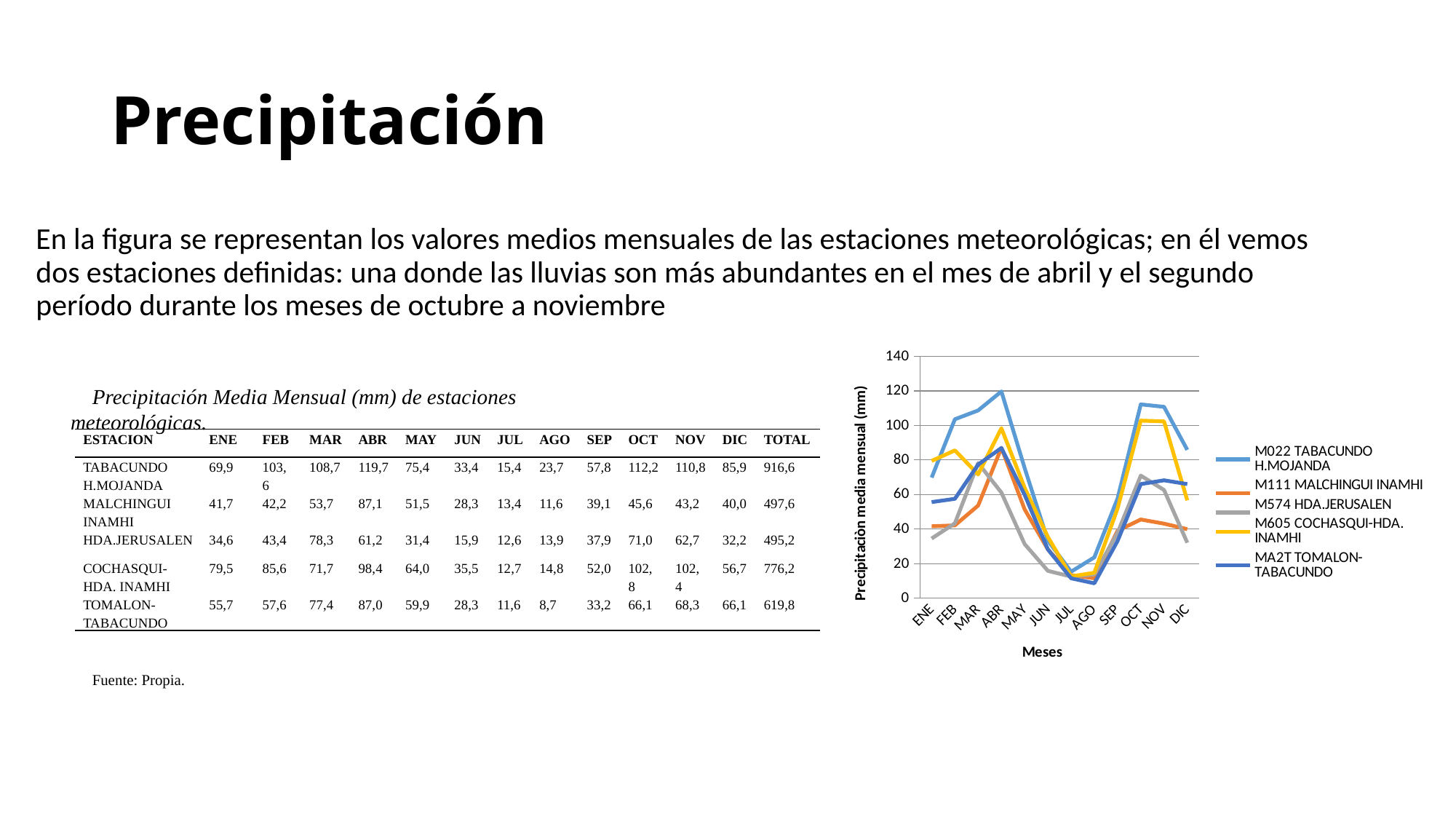
Between ABR and JUL, do the values of the M022 TABACUNDO H.MOJANDA series rise or fall? fall In ABR, which series has the higher value: M022 TABACUNDO H.MOJANDA or M111 MALCHINGUI INAMHI? M022 TABACUNDO H.MOJANDA In which month does the M022 TABACUNDO H.MOJANDA series reach its highest value? ABR Is the value for M605 COCHASQUI-HDA. INAMHI in ABR greater or less than 80? greater In which month does the M022 TABACUNDO H.MOJANDA series reach its lowest value? JUL What kind of chart is shown on the slide? line chart Is the value for M574 HDA.JERUSALEN in JUN greater or less than 20? less Is the value for M022 TABACUNDO H.MOJANDA in ABR greater or less than 100? greater How many months are plotted along the x axis of the chart? 12 How many series does the chart's legend list? 5 What is the title of the chart's vertical axis? Precipitación media mensual (mm) According to the table on the slide, what is the ABR value for TABACUNDO H.MOJANDA? 119,7